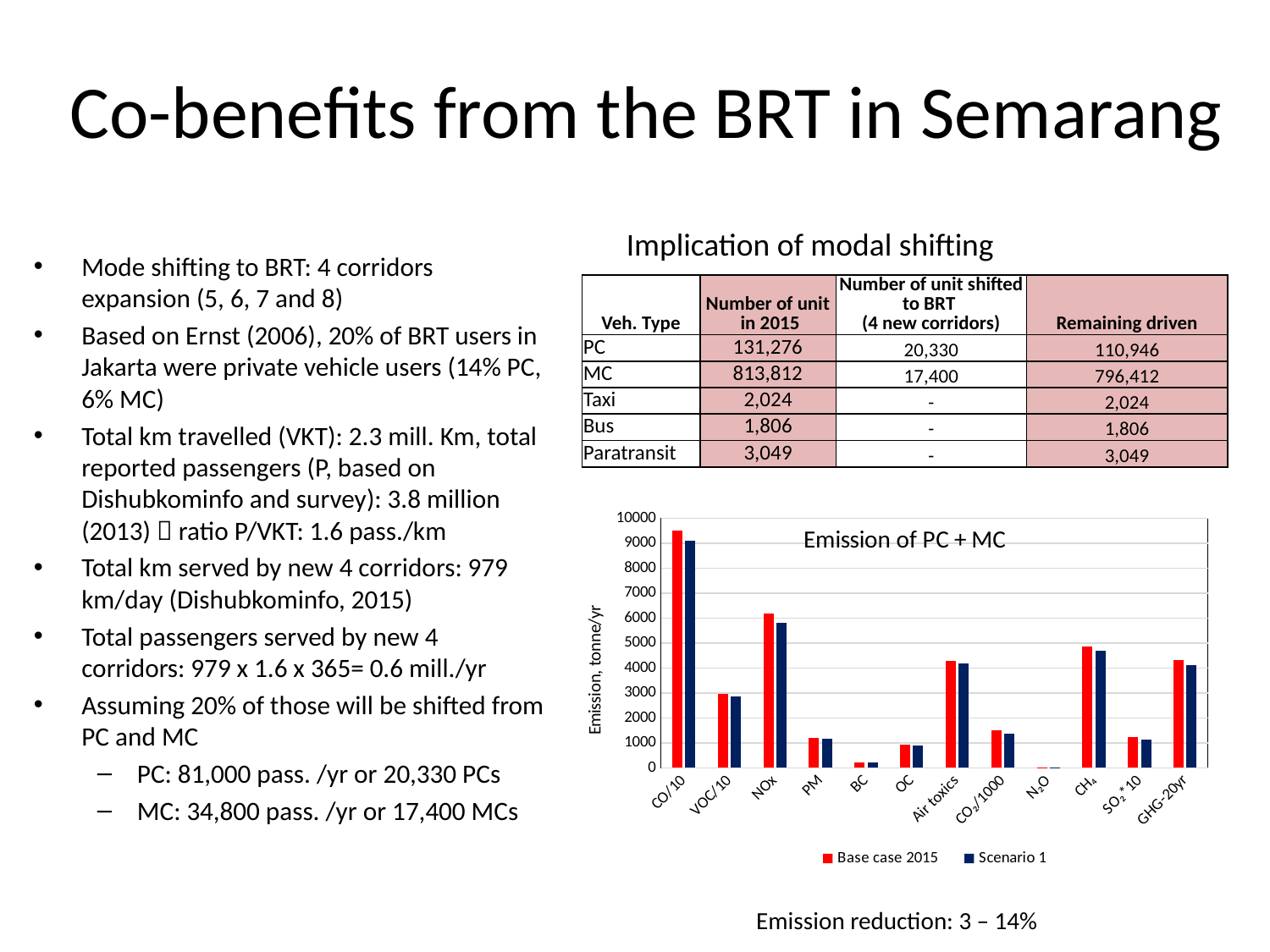
Is the Scenario 1 value for CO/10 greater or less than 8000? greater Which category has the highest Base case 2015 emission in the chart? CO/10 Is the Base case 2015 value for NOx greater or less than 5000? greater What kind of chart is shown on the slide? bar chart How many categories are shown on the x axis of the chart? 12 Which category has a larger Base case 2015 value: CH₄ or VOC/10? CH₄ What is the label of the y axis of the chart? Emission, tonne/yr How many series does the chart legend list? 2 Is the Base case 2015 value for PM greater or less than 2000? less Which category has the lowest Base case 2015 emission in the chart? N₂O What is the title of the chart? Emission of PC + MC Which is larger for NOx: the Base case 2015 value or the Scenario 1 value? Base case 2015